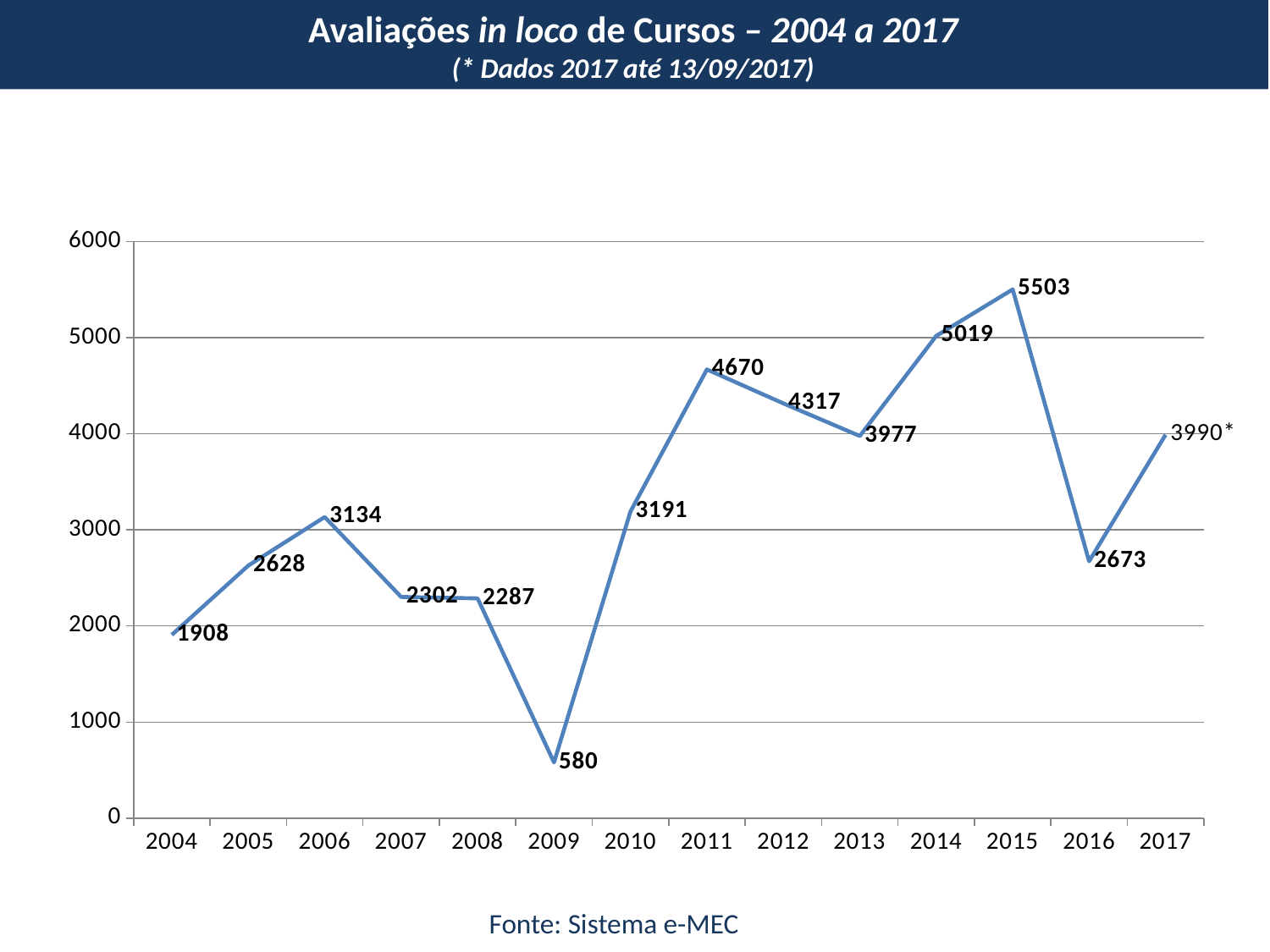
What is the difference between the values for 2015 and 2016? 2830 Which year has the highest value? 2015 What is the value for 2015? 5503 What kind of chart is shown? line chart What source is cited below the chart? Fonte: Sistema e-MEC Which year has the lowest value? 2009 What is the value for 2004? 1908 What is the value for 2009? 580 How many years are plotted on the x axis? 14 Is the value for 2013 greater or less than 3000? greater Which is larger, the value for 2011 or the value for 2014? 2014 Do the values rise or fall from 2004 to 2006? rise